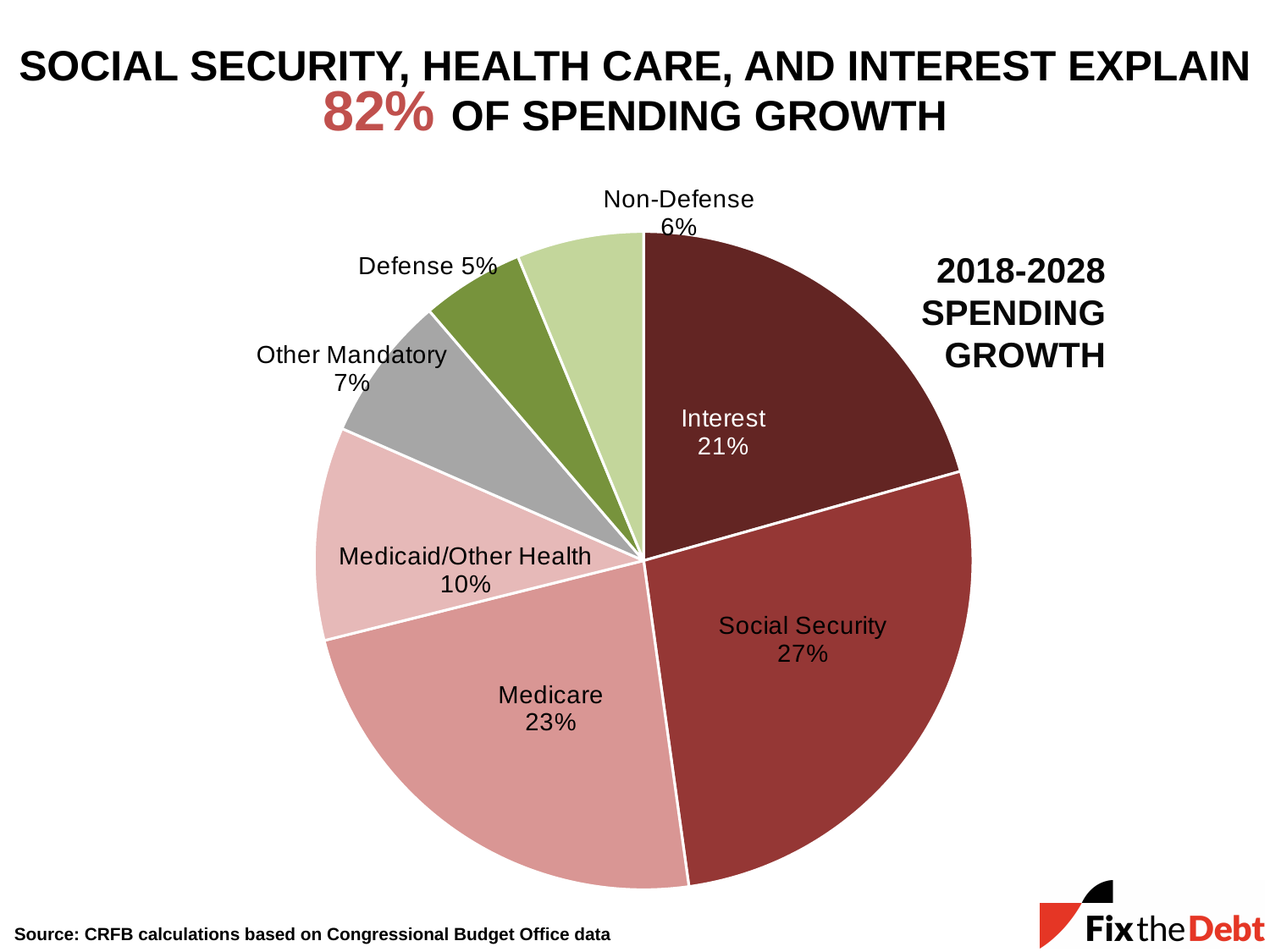
What share of 2018-2028 spending growth does Social Security account for? 27% What is the combined share of Social Security and Medicare? 50% What time period does the chart's label say the spending growth covers? 2018-2028 What type of chart is shown on the slide? Pie chart What is the share for Defense in the pie chart? 5% Which category has the smallest slice of the pie? Defense What share of spending growth is attributed to Interest? 21% Which category accounts for the largest share of spending growth? Social Security How many percentage points larger is the Medicare share than the Medicaid/Other Health share? 13 How many categories are shown in the pie chart? 7 What percentage of spending growth does Medicaid/Other Health represent? 10% Which is larger, the share for Other Mandatory or the share for Non-Defense? Other Mandatory